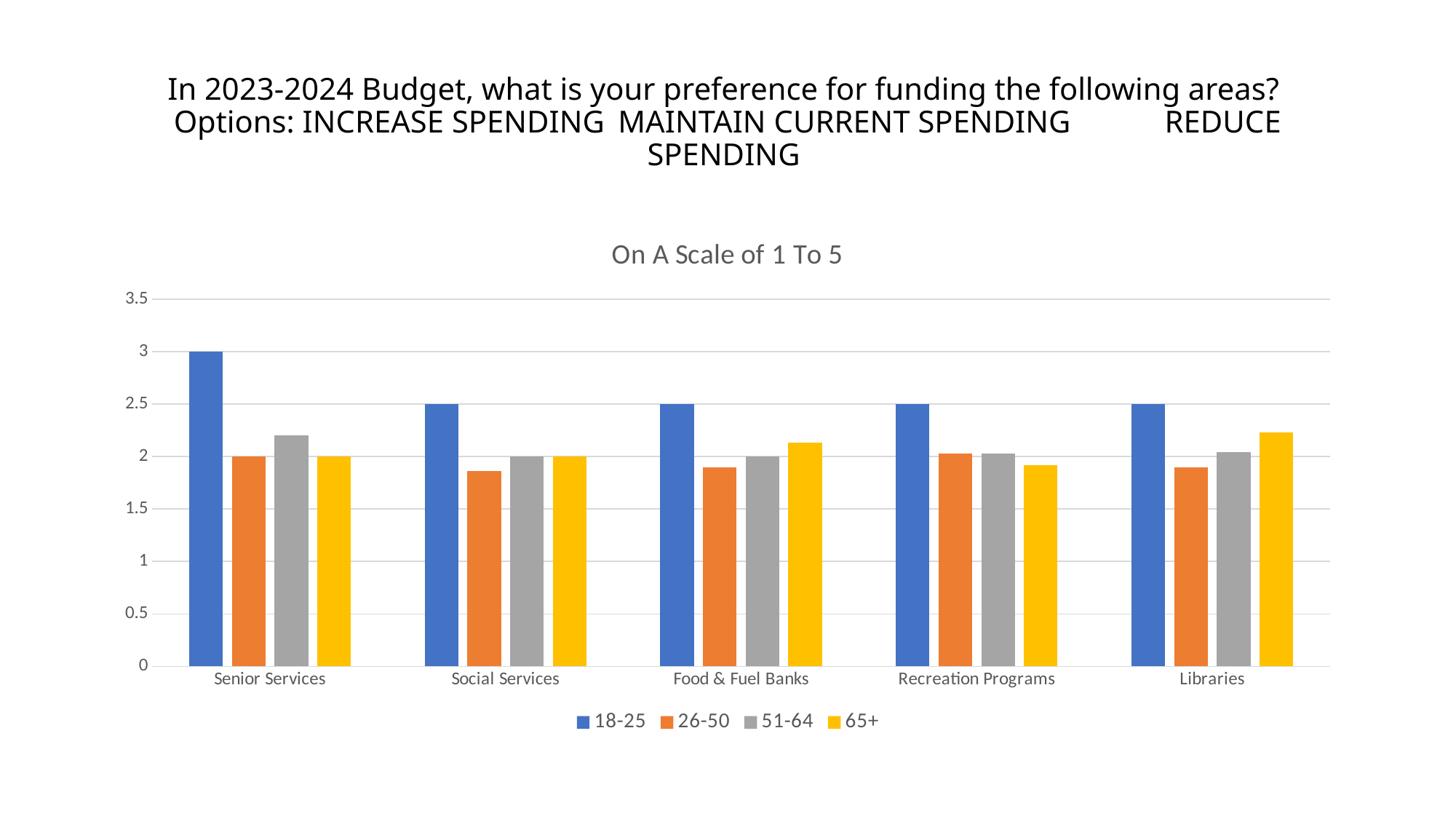
Which age group has the highest value for Senior Services? 18-25 Which is larger for the 18-25 series: Senior Services or Social Services? Senior Services Which age group has the lowest value for Social Services? 26-50 What is the value for the 18-25 series for Libraries? 2.5 What is the difference between the 18-25 values for Senior Services and Food & Fuel Banks? 0.5 How many series does the legend list? 4 What is the value for the 18-25 series for Senior Services? 3 Is the value for the 51-64 series for Senior Services greater or less than 2? greater How many categories are shown on the x axis of the chart? 5 What is the title of the chart? On A Scale of 1 To 5 Is the value for the 65+ series for Recreation Programs greater or less than 2? less What kind of chart is shown on the slide? Bar chart